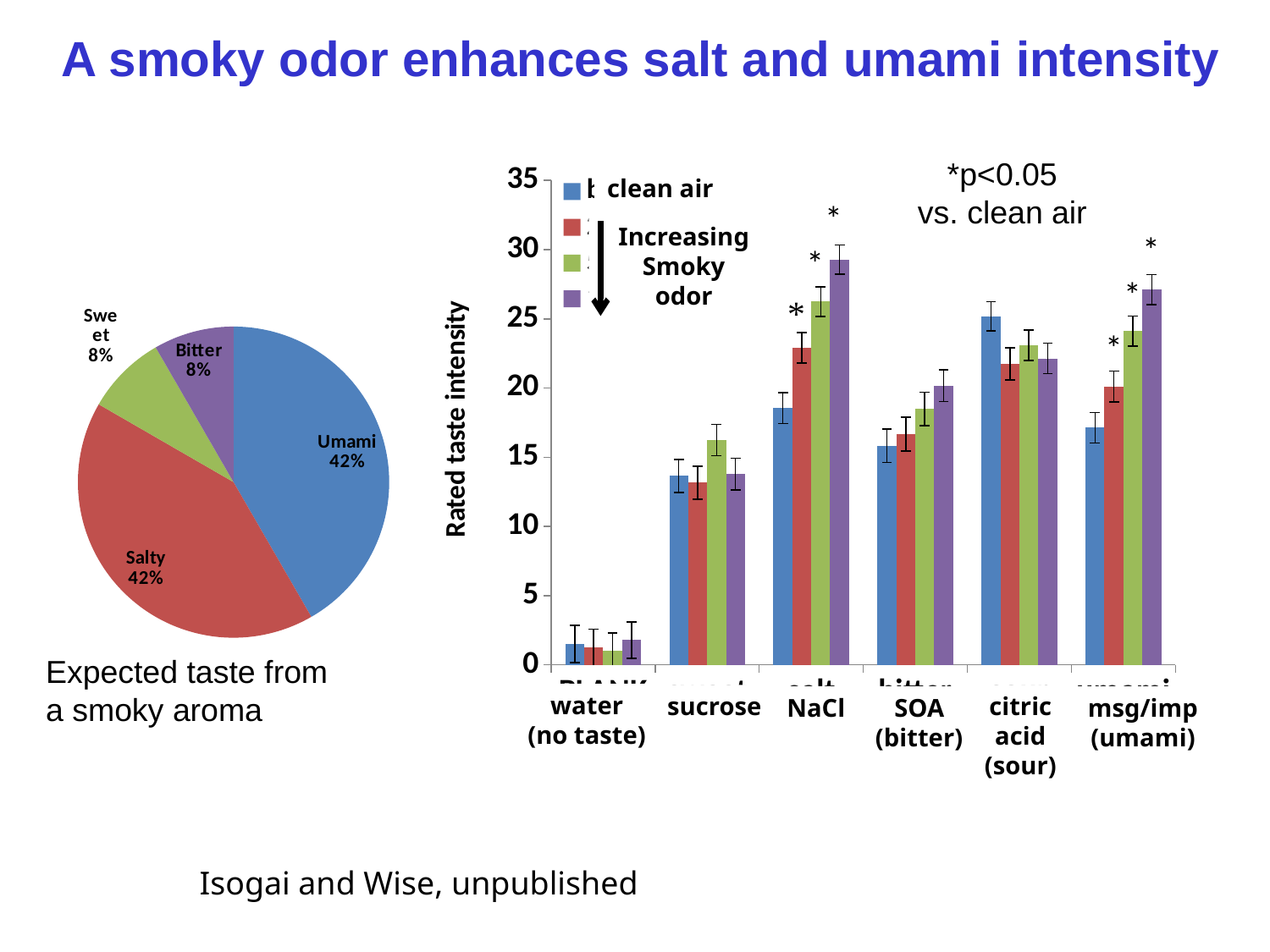
In the bar chart on the right, is the clean air value for NaCl greater or less than 15? greater What kind of chart is the chart on the right of the slide? Bar chart In the pie chart on the left, what percentage is shown for Umami? 42% In the bar chart on the right, how many taste categories are shown on the x axis? 6 In the bar chart on the right, what is the label of the y axis? Rated taste intensity In the pie chart on the left, what share of the pie does Salty take? 42% In the bar chart on the right, is the clean air value for sucrose greater or less than 15? less In the pie chart on the left, which is larger, the Umami slice or the Sweet slice? Umami In the pie chart on the left, what percentage is shown for Bitter? 8% In the pie chart on the left, how many slices are there? 4 In the pie chart on the left, what is the difference between the Umami and Sweet percentages? 34% In the bar chart on the right, how many series does the legend list? 4